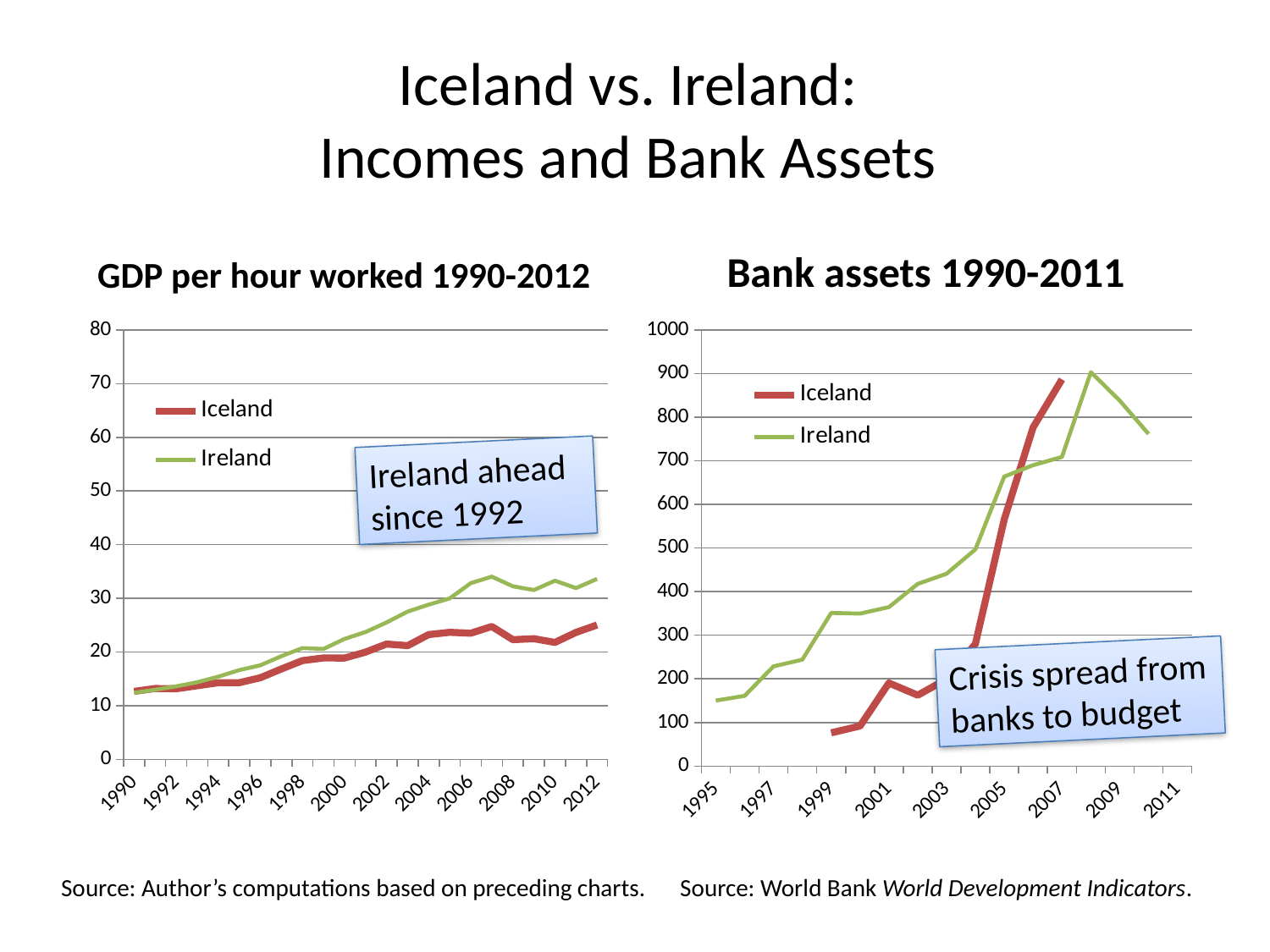
What kind of chart is the 'GDP per hour worked 1990-2012' chart? line chart In the 'GDP per hour worked 1990-2012' chart, which series is higher in 2012, Iceland or Ireland? Ireland In the 'Bank assets 1990-2011' chart, is the value for Ireland in 2010 greater or less than 700? greater In the 'GDP per hour worked 1990-2012' chart, what colour is the Iceland line? red In the 'Bank assets 1990-2011' chart, which series is higher in 2007, Iceland or Ireland? Iceland How many series does the legend of the 'Bank assets 1990-2011' chart list? 2 In the 'GDP per hour worked 1990-2012' chart, does the Ireland series generally rise or fall from 1990 to 2007? rise In the 'GDP per hour worked 1990-2012' chart, is the value for Iceland in 2012 greater or less than 30? less In the 'Bank assets 1990-2011' chart, does the Ireland series rise or fall between 2008 and 2010? fall In the 'Bank assets 1990-2011' chart, is the value for Iceland in 1999 greater or less than 100? less